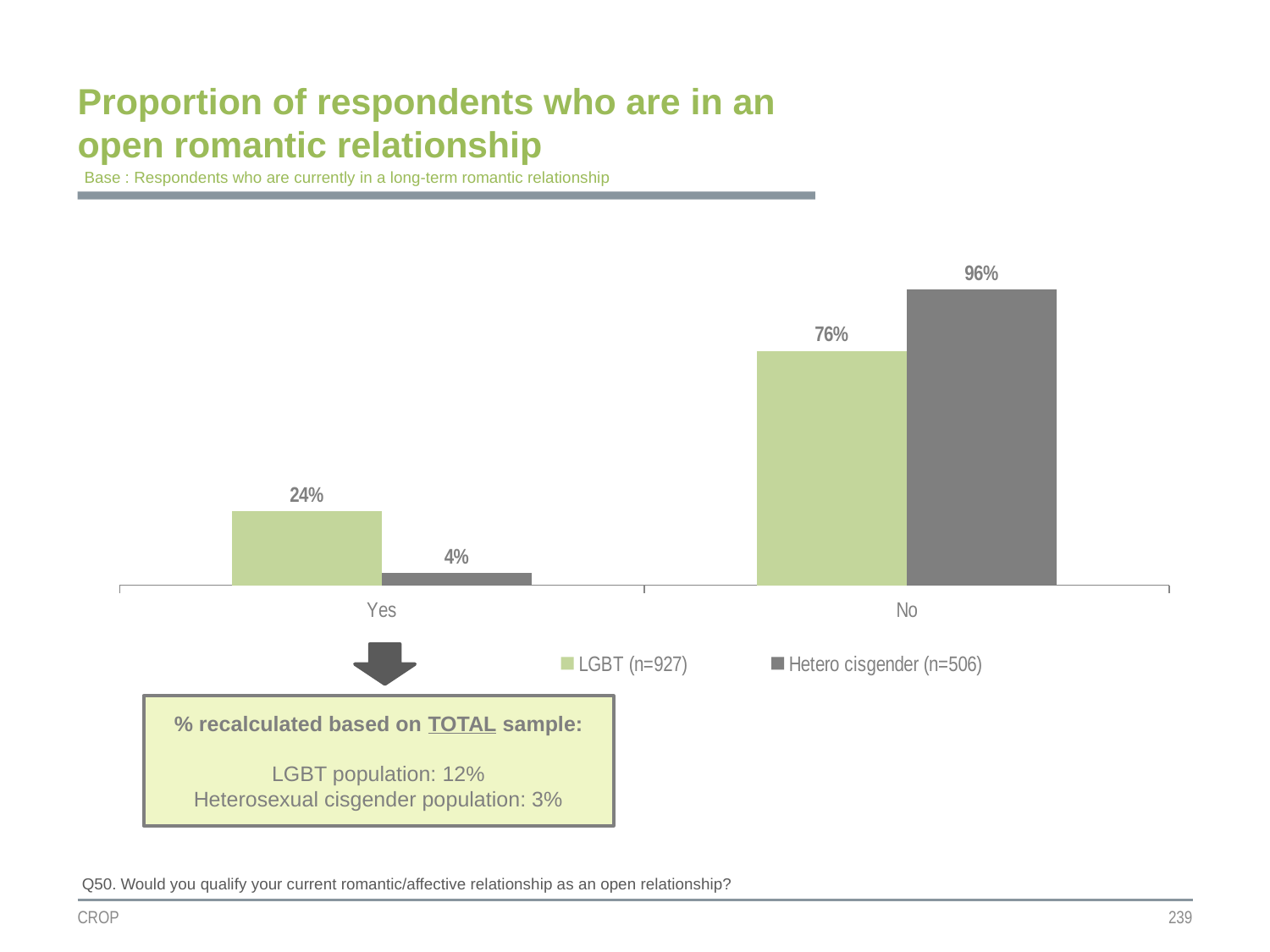
How many series does the legend list? 2 What is the sample size (n) for the LGBT series shown in the legend? 927 What percentage of Hetero cisgender respondents answered No? 96% What is the difference between the LGBT and Hetero cisgender values for Yes? 20 percentage points Which series has the higher value for Yes? LGBT (n=927) What is the difference between the Hetero cisgender and LGBT values for No? 20 percentage points What percentage of LGBT respondents answered No? 76% Which series has the higher value for No? Hetero cisgender (n=506) What kind of chart is shown on the slide? Bar chart What percentage of LGBT respondents answered Yes? 24% What percentage of Hetero cisgender respondents answered Yes? 4% How many categories are shown on the x axis? 2